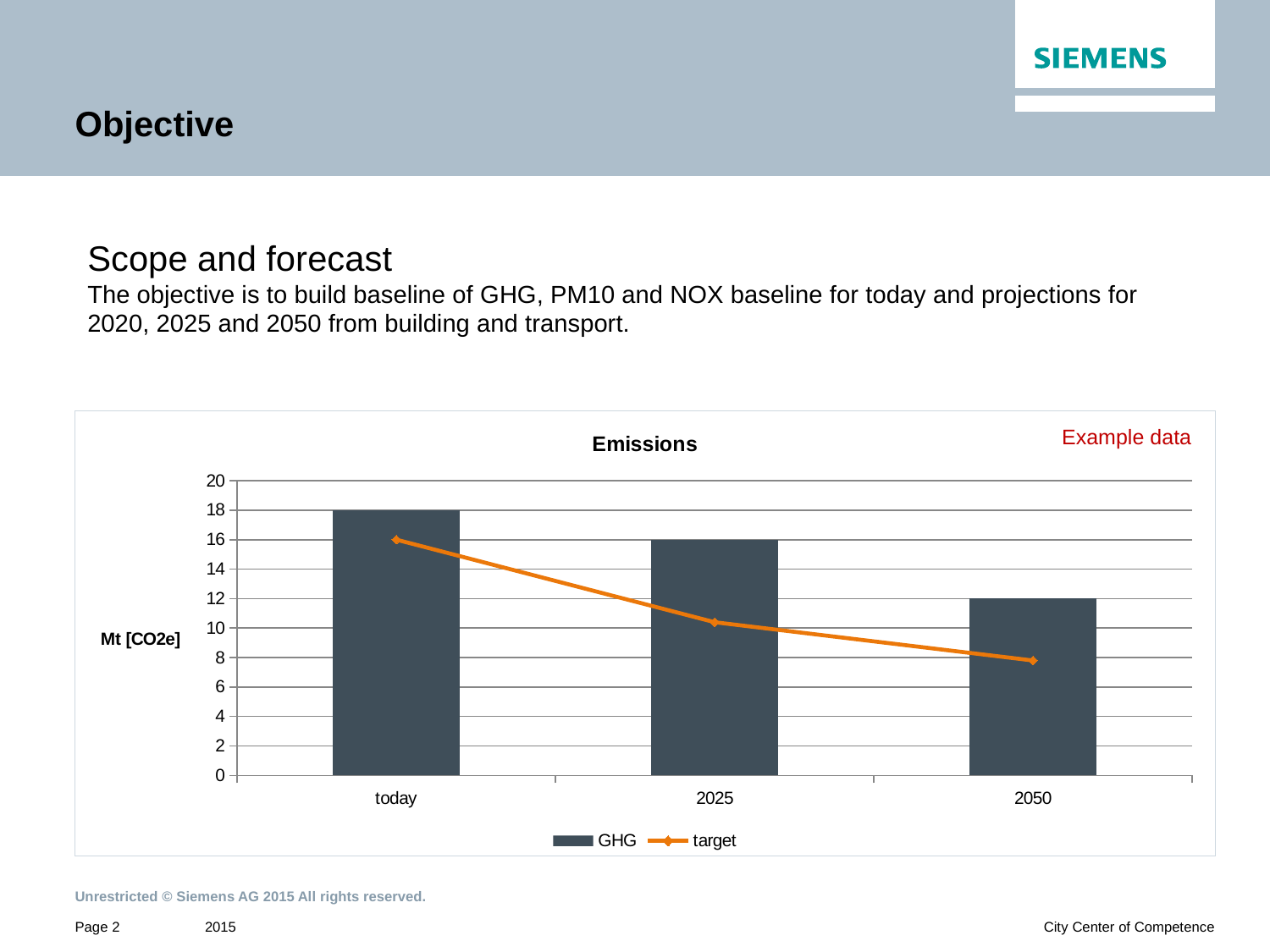
Do the GHG values rise or fall from today to 2050? fall Which category has the lowest GHG value? 2050 What is the GHG value for today in the Emissions chart? 18 How many series does the legend of the Emissions chart list? 2 What is the GHG value for 2050 in the Emissions chart? 12 What is the difference between the GHG value for today and the GHG value for 2050? 6 How many categories are shown on the x axis of the Emissions chart? 3 What is the label on the vertical axis of the Emissions chart? Mt [CO2e] Which category has the highest GHG value? today Is the target value for 2025 greater or less than 12? less What kind of chart is shown on the slide? A bar chart with a line series Which is larger for 2025, the GHG value or the target value? GHG